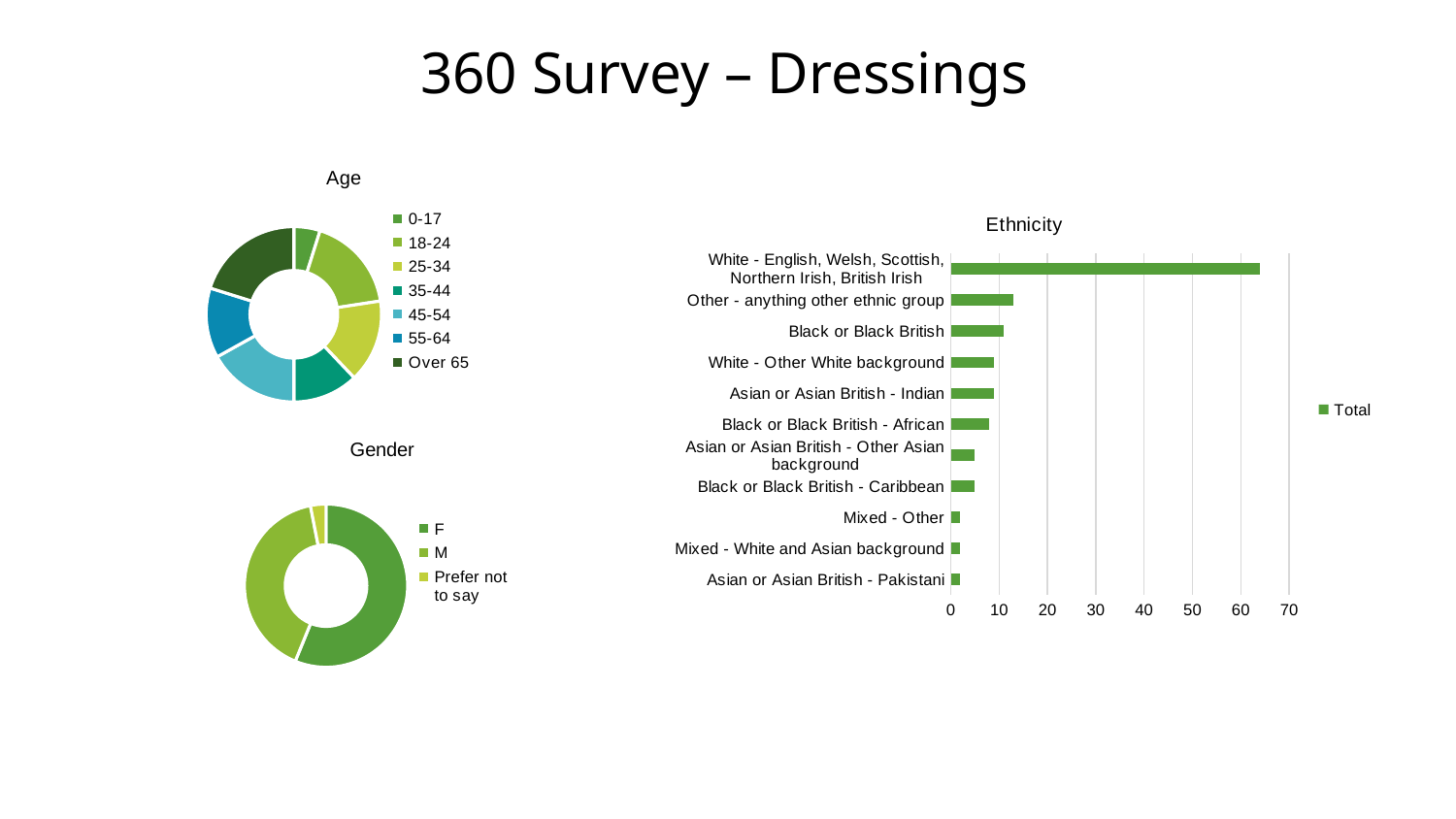
What kind of chart is the Ethnicity chart? bar chart On the Ethnicity chart, which ethnic group has the highest value? White - English, Welsh, Scottish, Northern Irish, British Irish How many series does the legend of the Ethnicity chart list? 1 What kind of chart is the Gender chart? doughnut chart How many age groups does the legend of the Age chart list? 7 On the Ethnicity chart, which is larger: Other - anything other ethnic group or Black or Black British - African? Other - anything other ethnic group How many ethnic groups are listed on the Ethnicity chart? 11 On the Ethnicity chart, is the value for White - English, Welsh, Scottish, Northern Irish, British Irish greater or less than 60? greater On the Age chart, which age group has the smallest slice? 0-17 On the Gender chart, which category has the largest slice? F On the Ethnicity chart, is the value for Other - anything other ethnic group greater or less than 20? less